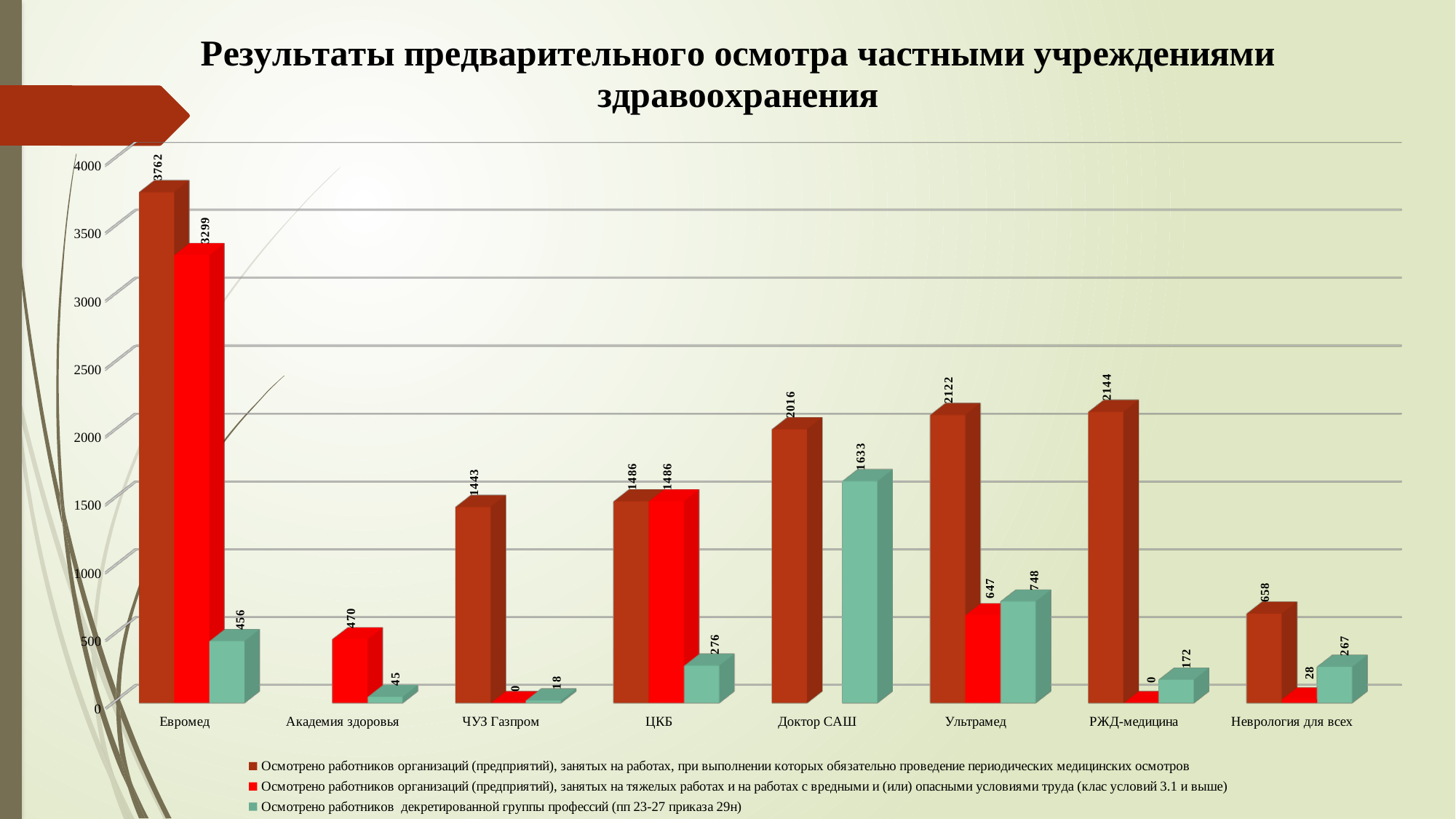
What is the value of the red series (hard and harmful work) for Ультрамед? 647 What is the value of the dark red series (periodic medical exams) for Евромед? 3762 Is the dark red series value for РЖД-медицина greater or less than 2000? greater How many series does the legend list? 3 What is the title of the chart? Результаты предварительного осмотра частными учреждениями здравоохранения Which institution has the lowest value in the teal series (decreed group of professions)? ЧУЗ Газпром What is the difference between the dark red and red series values for Евромед? 463 How many institutions (categories) are shown on the x axis? 8 What is the value of the teal series (decreed group of professions) for Доктор САШ? 1633 Which is larger for Ультрамед: the red series value or the teal series value? the teal series value (748) Which institution has the highest value in the dark red series (periodic medical exams)? Евромед What type of chart is shown on the slide? bar chart